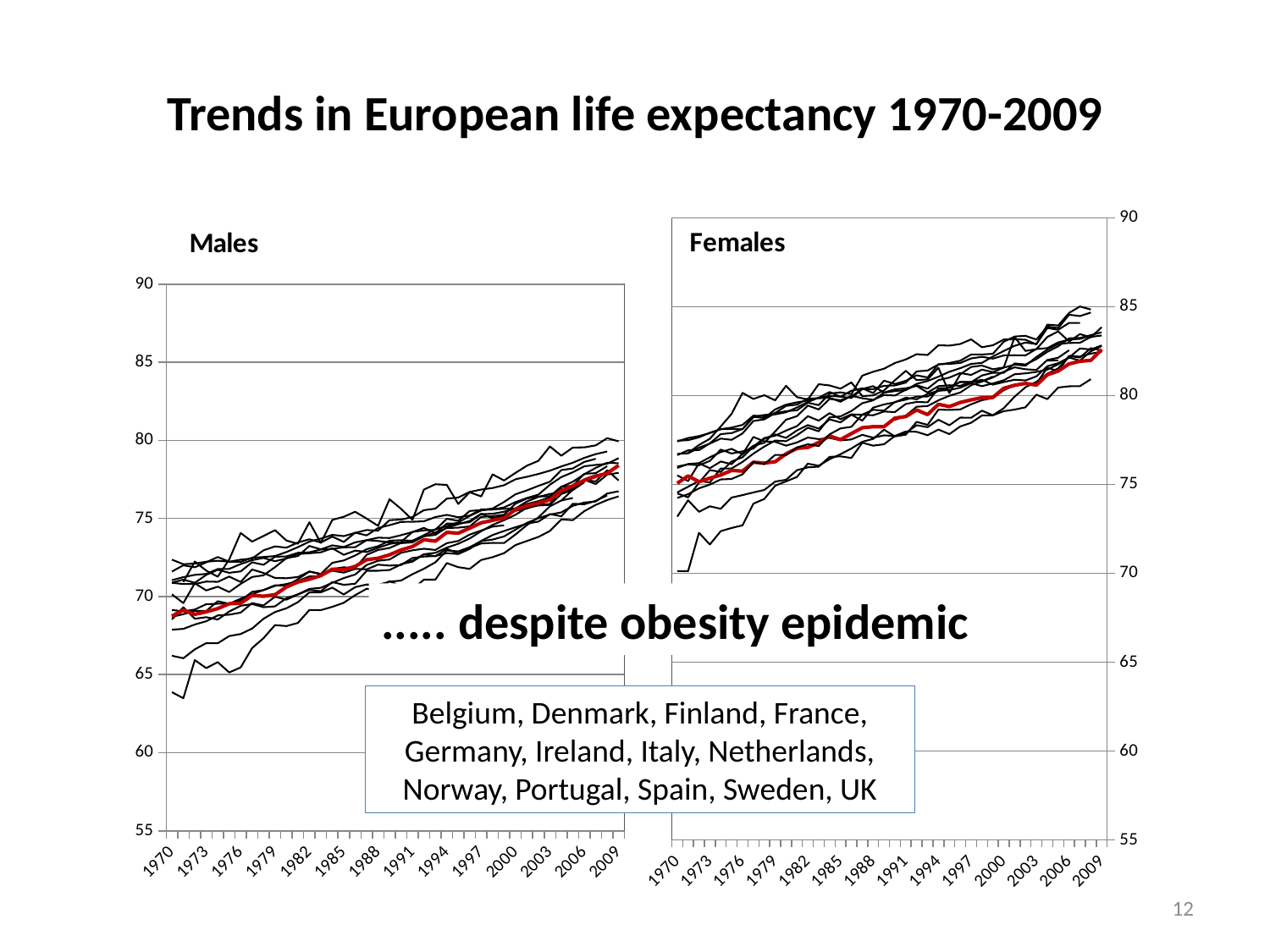
In the Males chart, is the value of the red line in 2009 greater or less than 75? greater What is the maximum value shown on the y axis of the Males chart? 90 In the Males chart, is the lowest line's value in 1970 greater or less than 65? less Which chart's red line is higher in 2009, the Males chart or the Females chart? Females What kind of chart is the Males chart? line chart In the Males chart, do the life expectancy lines rise or fall from 1970 to 2009? rise In the Females chart, is the lowest line's value in 1970 greater or less than 75? less In the Females chart, do the life expectancy lines rise or fall from 1970 to 2009? rise What is the title of the slide's chart display? Trends in European life expectancy 1970-2009 In the Males chart, is the red line's value higher in 2009 or in 1970? 2009